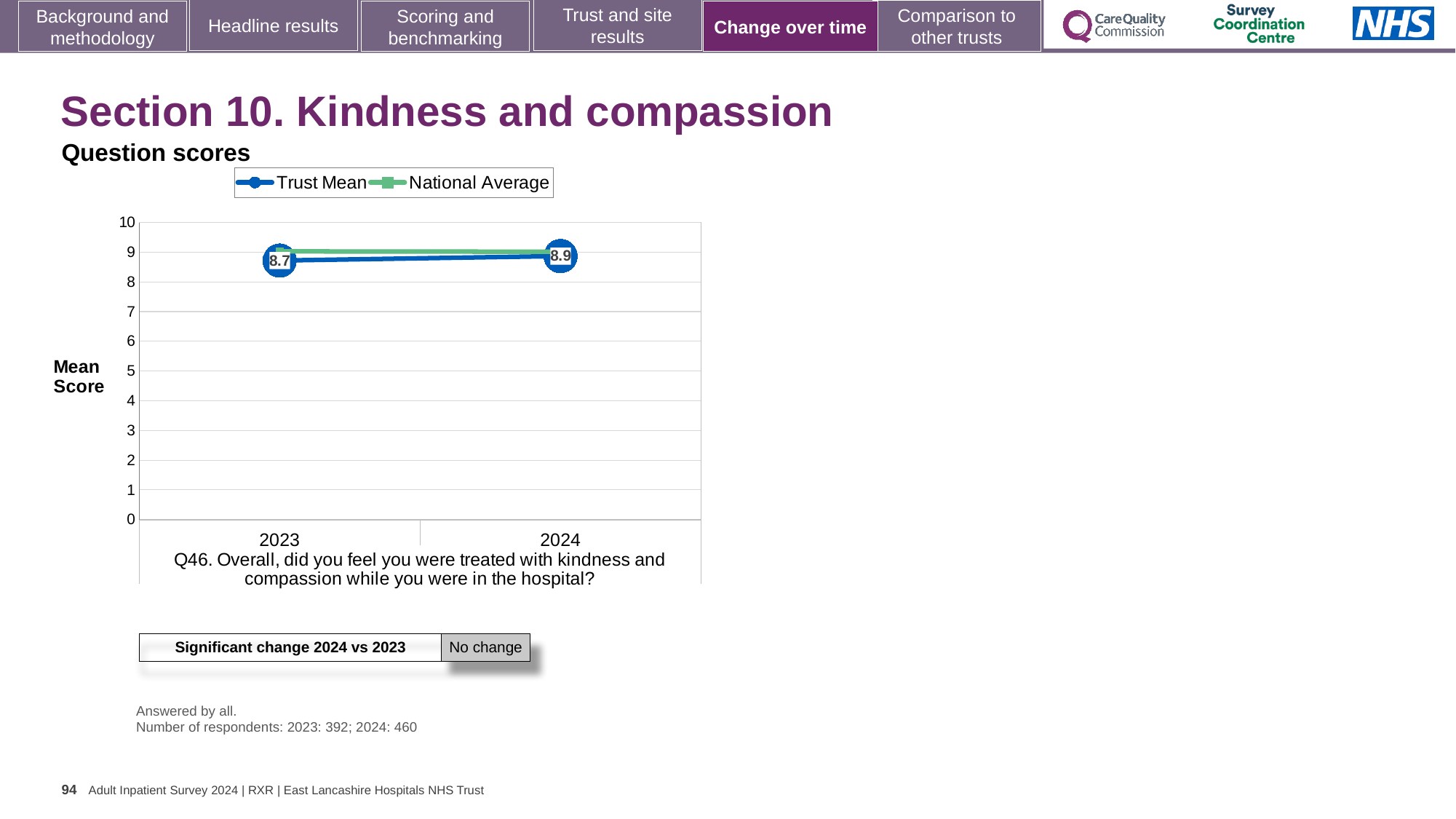
What is the difference between the Trust Mean scores for 2024 and 2023? 0.2 Is the National Average value for 2023 greater or less than 5? greater What is the label of the y axis of the chart? Mean Score Which is larger, the Trust Mean score for 2023 or for 2024? 2024 What is the Trust Mean score for 2023? 8.7 What is the Trust Mean score for 2024? 8.9 In which year is the Trust Mean score highest? 2024 Does the Trust Mean score rise or fall from 2023 to 2024? rise What kind of chart is shown on the slide? line chart In which year is the Trust Mean score lowest? 2023 How many years are shown on the x axis of the chart? 2 How many series does the chart legend list? 2